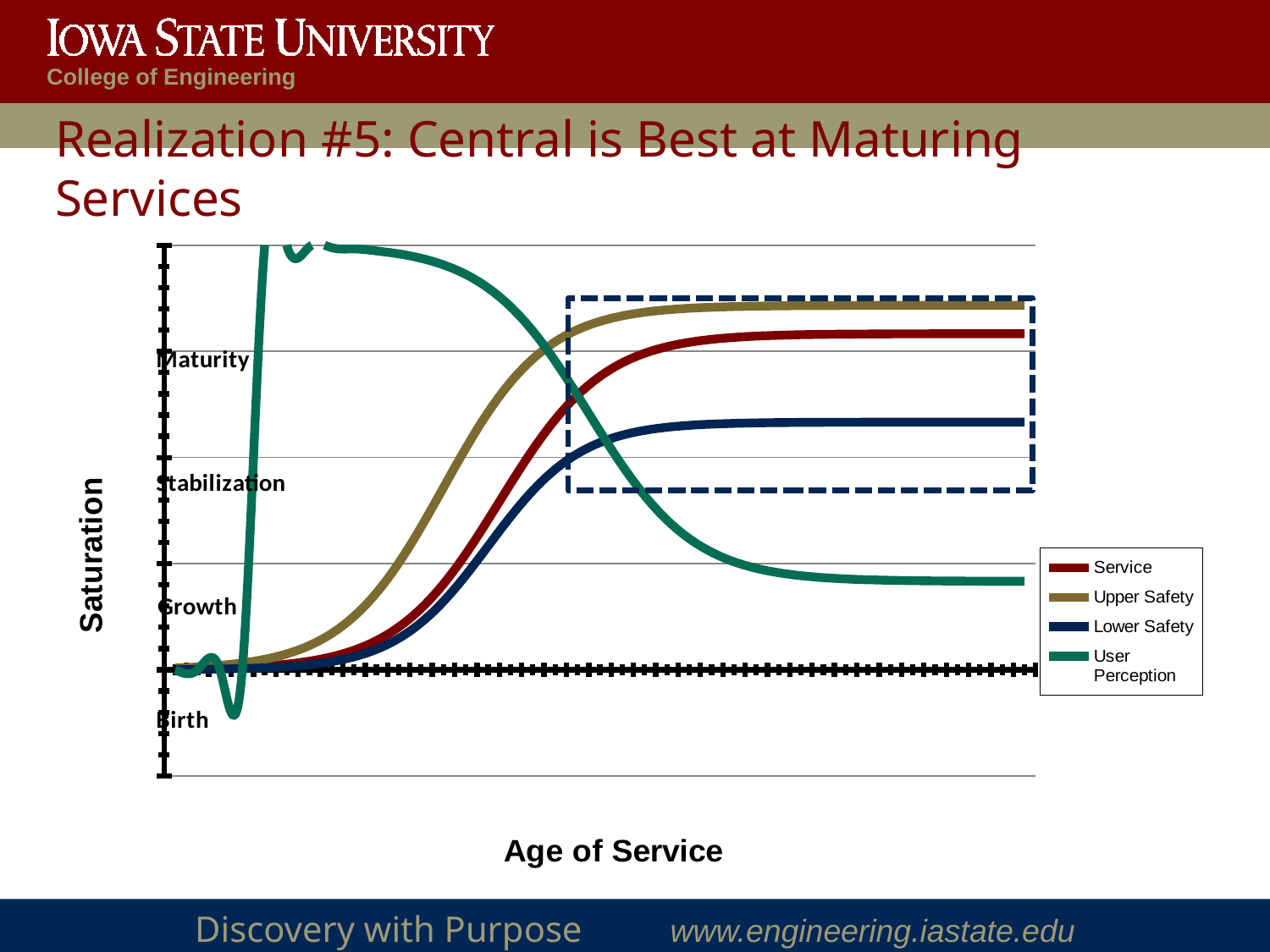
Which series is drawn in green? User Perception Which series ends lowest at the right end of the chart? User Perception What kind of chart is shown on the slide? Line chart What is the title of the x axis? Age of Service How many series does the legend list? 4 What is the title of the y axis? Saturation At the right end of the chart, which is higher: Service or Lower Safety? Service Which series ends highest at the right end of the chart? Upper Safety Does the Upper Safety line rise or fall as Age of Service increases? Rises At the right end of the chart, which is higher: Upper Safety or Lower Safety? Upper Safety Does the Service line rise or fall as Age of Service increases? Rises